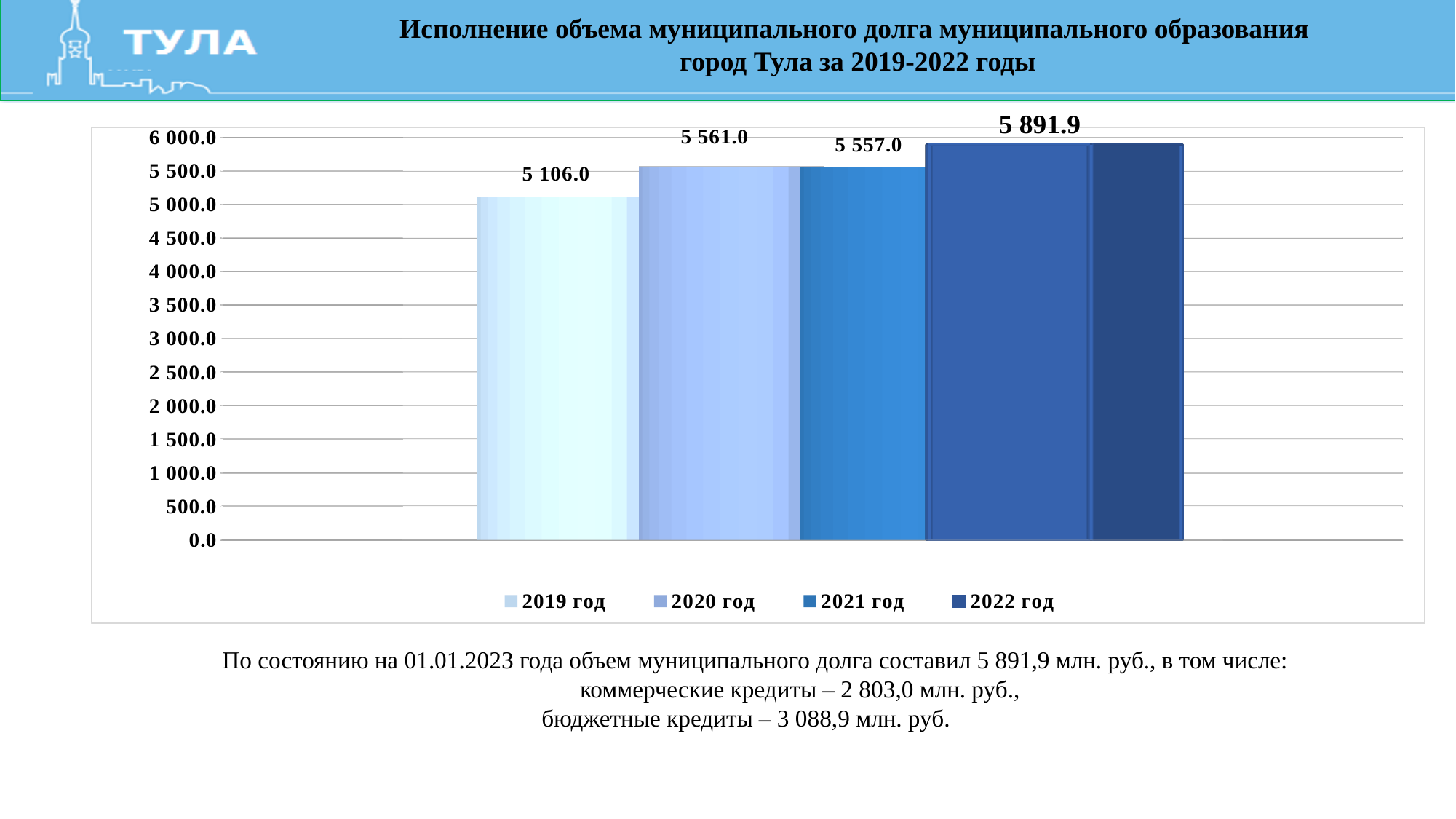
How many series does the legend list? 4 What is the value shown for 2022 год? 5 891.9 Which year has the lowest value on the chart? 2019 год What kind of chart is shown on the slide? bar chart What is the value shown for 2019 год? 5 106.0 Is the value for 2022 год greater or less than 6 000.0? less What is the difference between the values for 2022 год and 2019 год? 785.9 What is the value shown for 2020 год? 5 561.0 What is the difference between the values for 2020 год and 2021 год? 4.0 Which year has the highest value on the chart? 2022 год Which is larger, the value for 2020 год or the value for 2021 год? 2020 год What is the value shown for 2021 год? 5 557.0